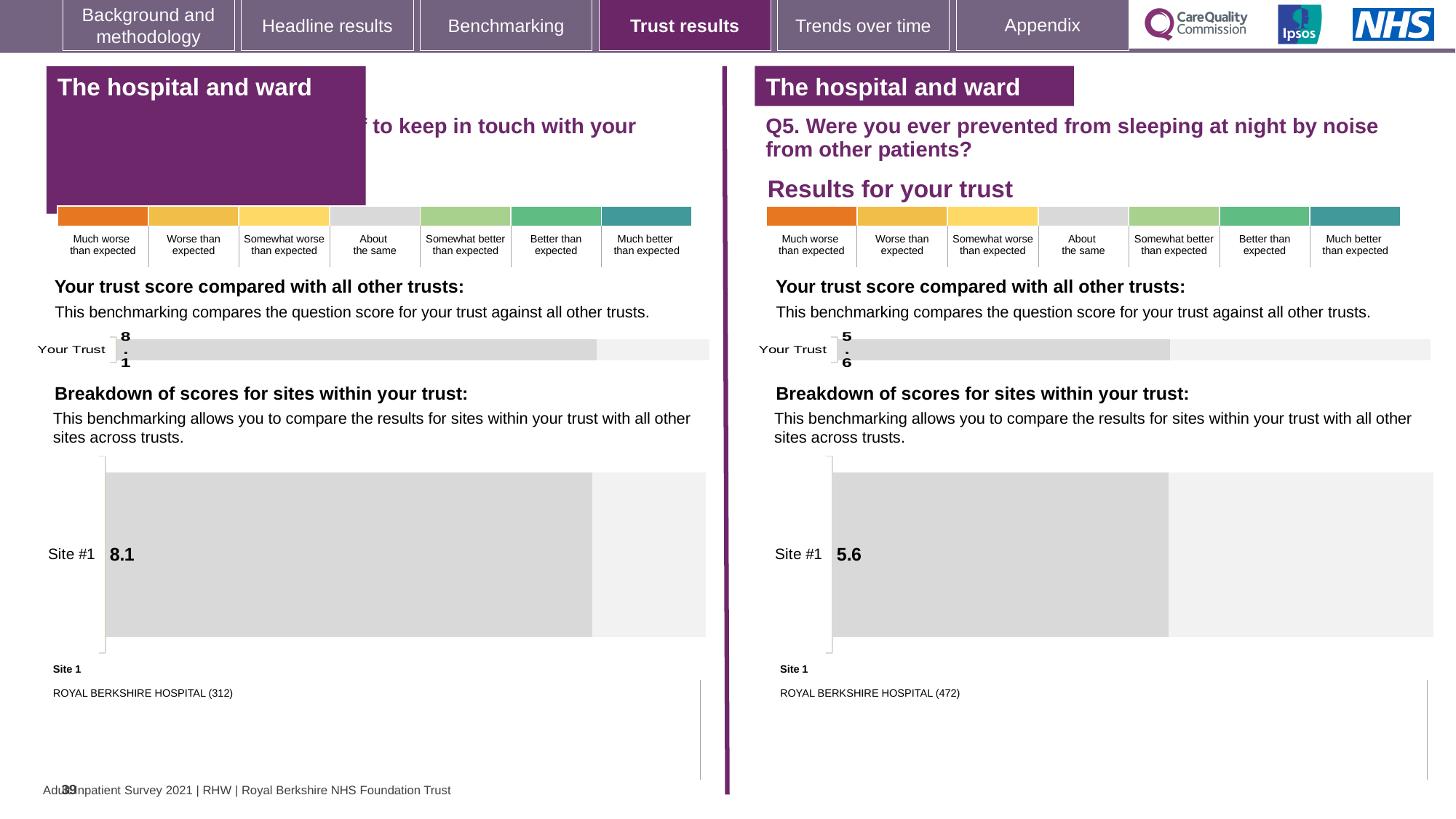
On the right half of the slide (Q5), is the Site #1 score the same as the Your Trust score? Yes, both are 5.6 How many sites are shown in the 'Breakdown of scores for sites within your trust' chart on the left half of the slide? 1 On the right half of the slide (Q5), in the 'Your trust score compared with all other trusts' chart, what is the value for Your Trust? 5.6 On the left half of the slide, in the 'Breakdown of scores for sites within your trust' chart, what is the value for Site #1? 8.1 On the right half of the slide (Q5), which site name is listed as Site 1 below the breakdown chart? ROYAL BERKSHIRE HOSPITAL (472) On the left half of the slide, which site name is listed as Site 1 below the breakdown chart? ROYAL BERKSHIRE HOSPITAL (312) How many sites are shown in the 'Breakdown of scores for sites within your trust' chart on the right half of the slide (Q5)? 1 On the left half of the slide, in the 'Your trust score compared with all other trusts' chart, what is the value for Your Trust? 8.1 What kind of chart is used to show the Site #1 score on the right half of the slide (Q5)? Bar chart What is the difference between the Site #1 score on the left half of the slide and the Site #1 score on the right half (Q5)? 2.5 On the right half of the slide (Q5), in the 'Breakdown of scores for sites within your trust' chart, what is the value for Site #1? 5.6 Which is larger: the Your Trust score on the left half of the slide or the Your Trust score on the right half (Q5)? Left half (8.1)